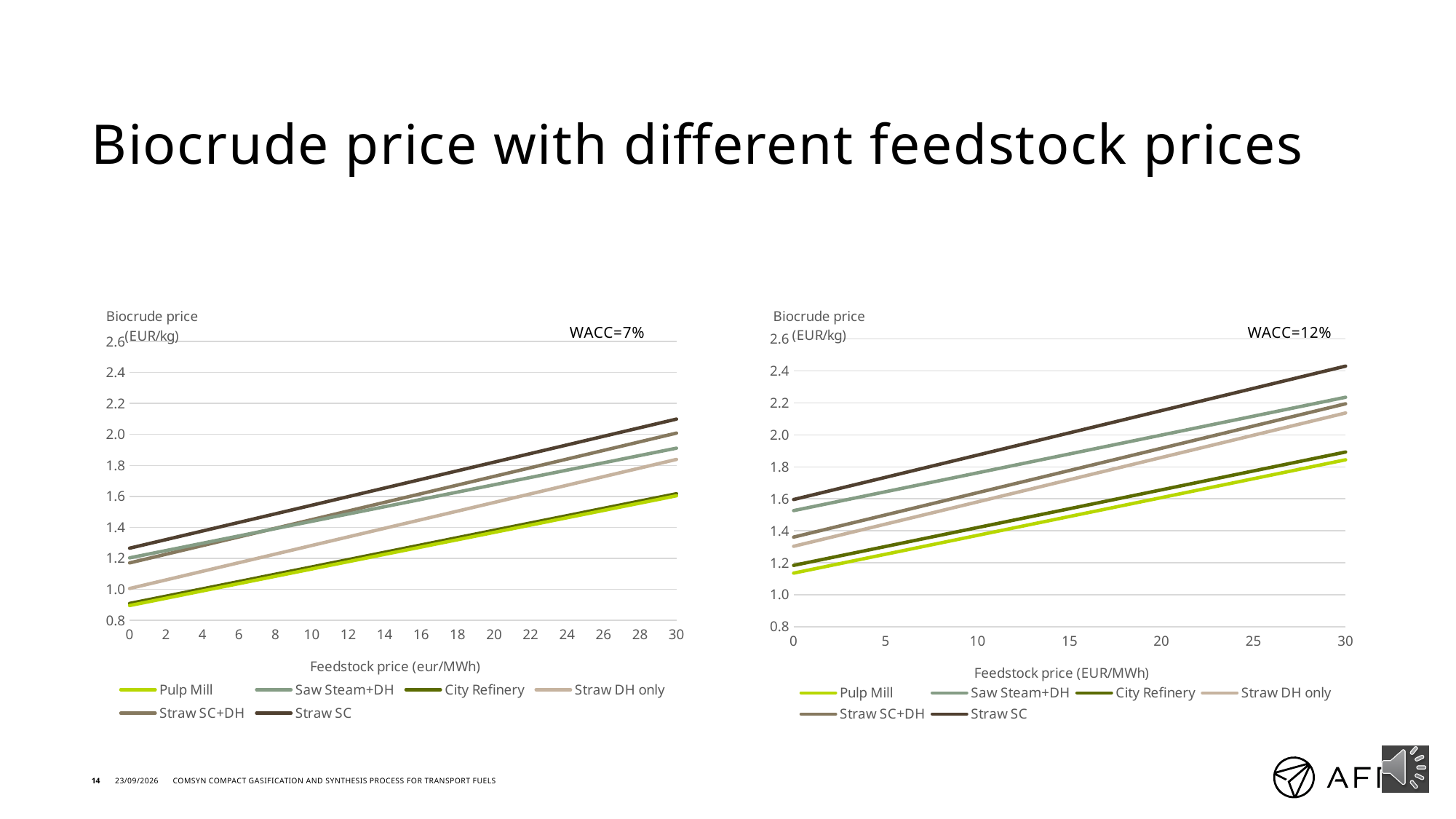
In the WACC=12% chart on the right, is the biocrude price for Pulp Mill at a feedstock price of 0 greater or less than 1.2? less In the WACC=12% chart on the right, at a feedstock price of 0, which is higher: Saw Steam+DH or Straw DH only? Saw Steam+DH In the WACC=7% chart on the left, does the biocrude price for Straw SC rise or fall as feedstock price increases? rise In the WACC=7% chart on the left, is the biocrude price for Pulp Mill at a feedstock price of 30 greater or less than 1.8? less What is the x-axis label of the WACC=7% chart on the left? Feedstock price (eur/MWh) In the WACC=7% chart on the left, at a feedstock price of 30, which is higher: Straw SC+DH or Straw DH only? Straw SC+DH In the WACC=12% chart on the right, which series has the highest biocrude price at a feedstock price of 30? Straw SC In the WACC=7% chart on the left, which series has the highest biocrude price at a feedstock price of 30? Straw SC In the WACC=7% chart on the left, is the biocrude price for Straw SC at a feedstock price of 30 greater or less than 2.0? greater What kind of chart is the WACC=7% chart on the left? line chart How many series does the legend of the WACC=12% chart on the right list? 6